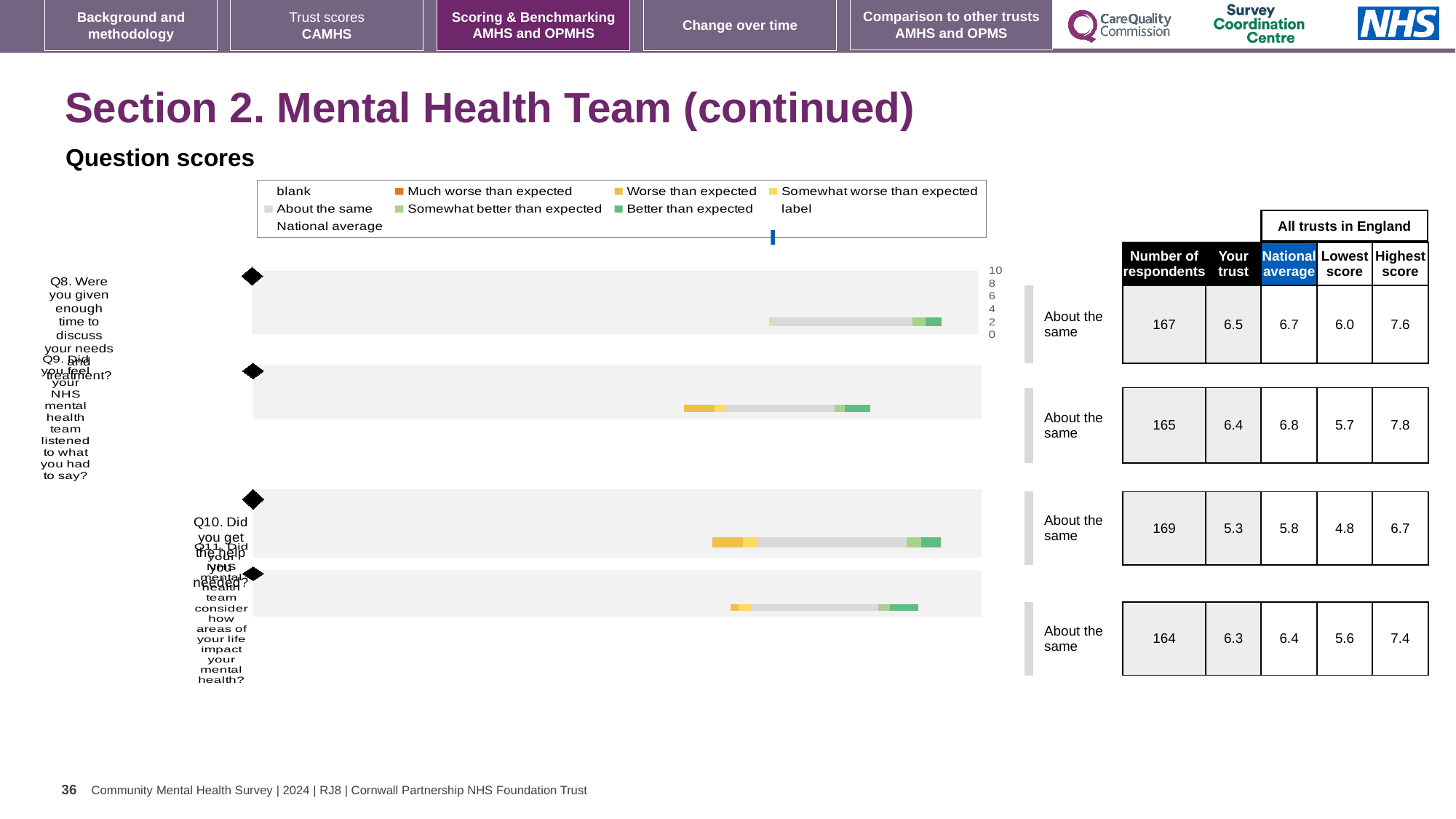
How many questions (Q8 to Q11) are plotted in the question score charts on this slide? 4 In the table beside the charts, what is the highest score across all trusts in England for Q11? 7.4 Which question has the lowest 'Your trust' score in the table beside the charts? Q10 In the table beside the charts, what is the national average for Q9 (Did you feel your NHS mental health team listened to what you had to say)? 6.8 What is the maximum value shown on the score axis of the charts? 10 What is the difference between the national average and the 'Your trust' score for Q10? 0.5 Which question has the highest 'Your trust' score in the table beside the charts? Q8 In the table beside the charts, what is the 'Your trust' score for Q8 (Were you given enough time to discuss your needs and treatment)? 6.5 What benchmark category is shown for Q8 next to its chart? About the same In the table beside the charts, what is the number of respondents for Q10 (Did you get the help you needed)? 169 What kind of chart is used to show the question scores on this slide? bar chart For Q9, which is larger: the 'Your trust' score or the national average? National average